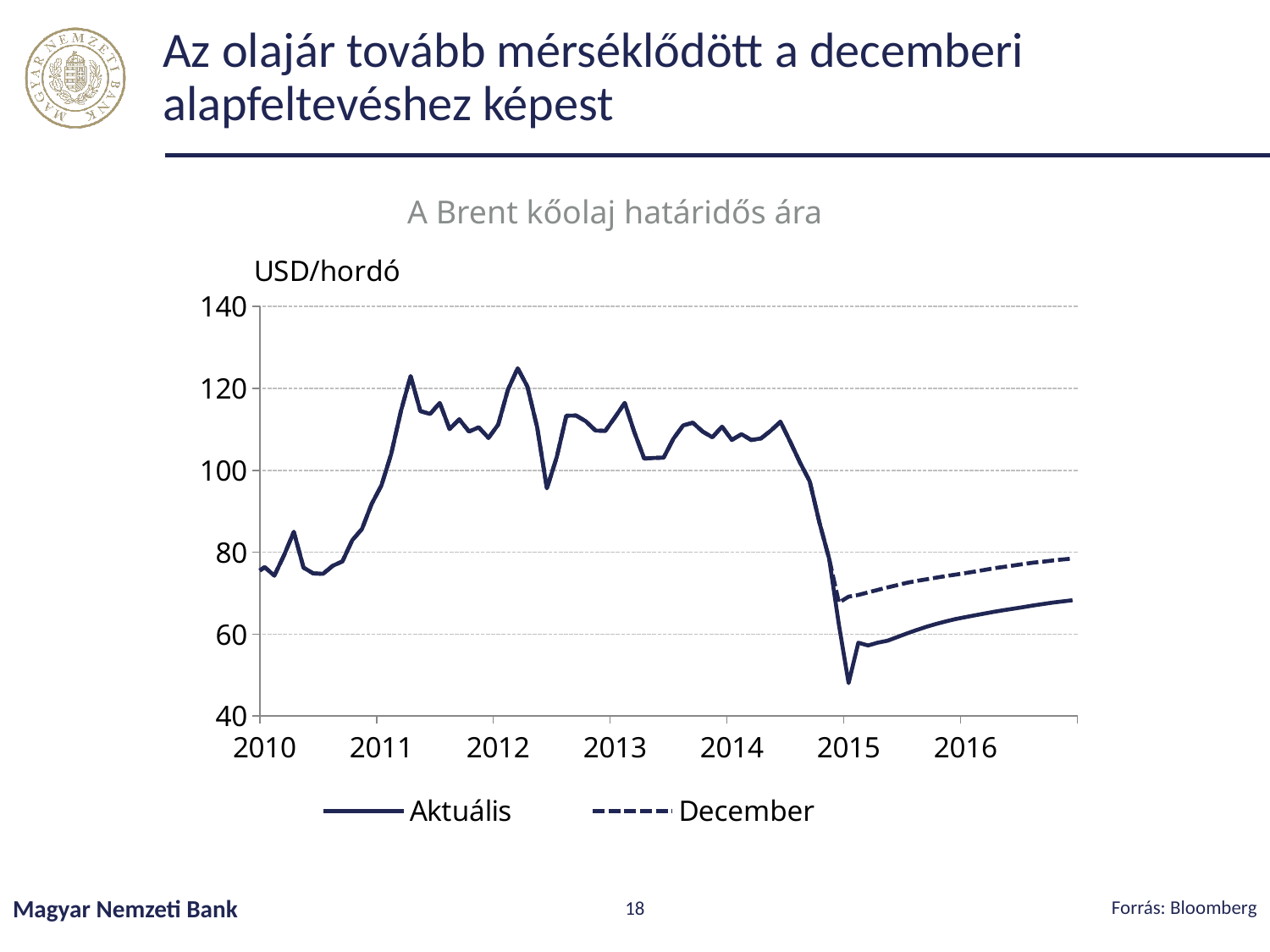
Does the Aktuális line rise or fall from early 2015 to the end of 2016? rise What are the two series named in the legend? Aktuális and December Is the Aktuális value at the start of 2010 greater or less than 80? less Is the Aktuális value at the end of 2016 greater or less than 60? greater Is the lowest point of the Aktuális line in early 2015 greater or less than 60? less How many series does the legend list? 2 What is the title of the chart? A Brent kőolaj határidős ára Does the Aktuális line rise or fall from mid-2014 to early 2015? fall What kind of chart is shown on the slide? line chart At the end of 2016, which series is higher, Aktuális or December? December